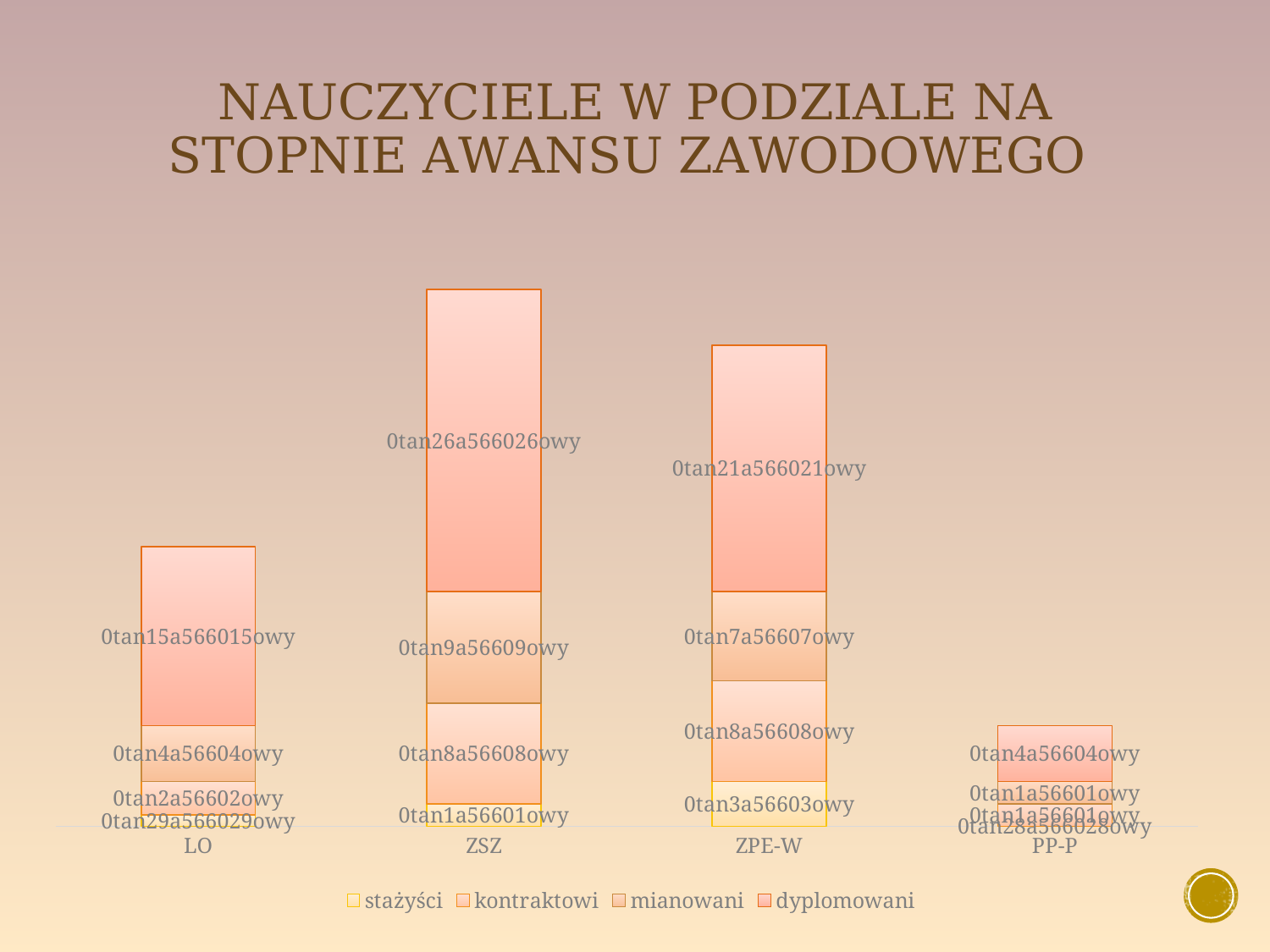
How many categories are shown on the x axis of the chart? 4 Which category has the tallest stacked bar overall? ZSZ Which stacked bar is taller, LO or PP-P? LO Which category has the larger dyplomowani segment, ZSZ or LO? ZSZ How many series does the chart legend list? 4 What kind of chart is shown on the slide? stacked bar chart Which series forms the largest segment of the ZSZ bar? dyplomowani Which stacked bar is taller, ZSZ or ZPE-W? ZSZ What is the title of the chart? NAUCZYCIELE W PODZIALE NA STOPNIE AWANSU ZAWODOWEGO Which series are listed in the chart legend? stażyści, kontraktowi, mianowani, dyplomowani Which category is shown furthest to the right on the x axis? PP-P Which category has the shortest stacked bar overall? PP-P